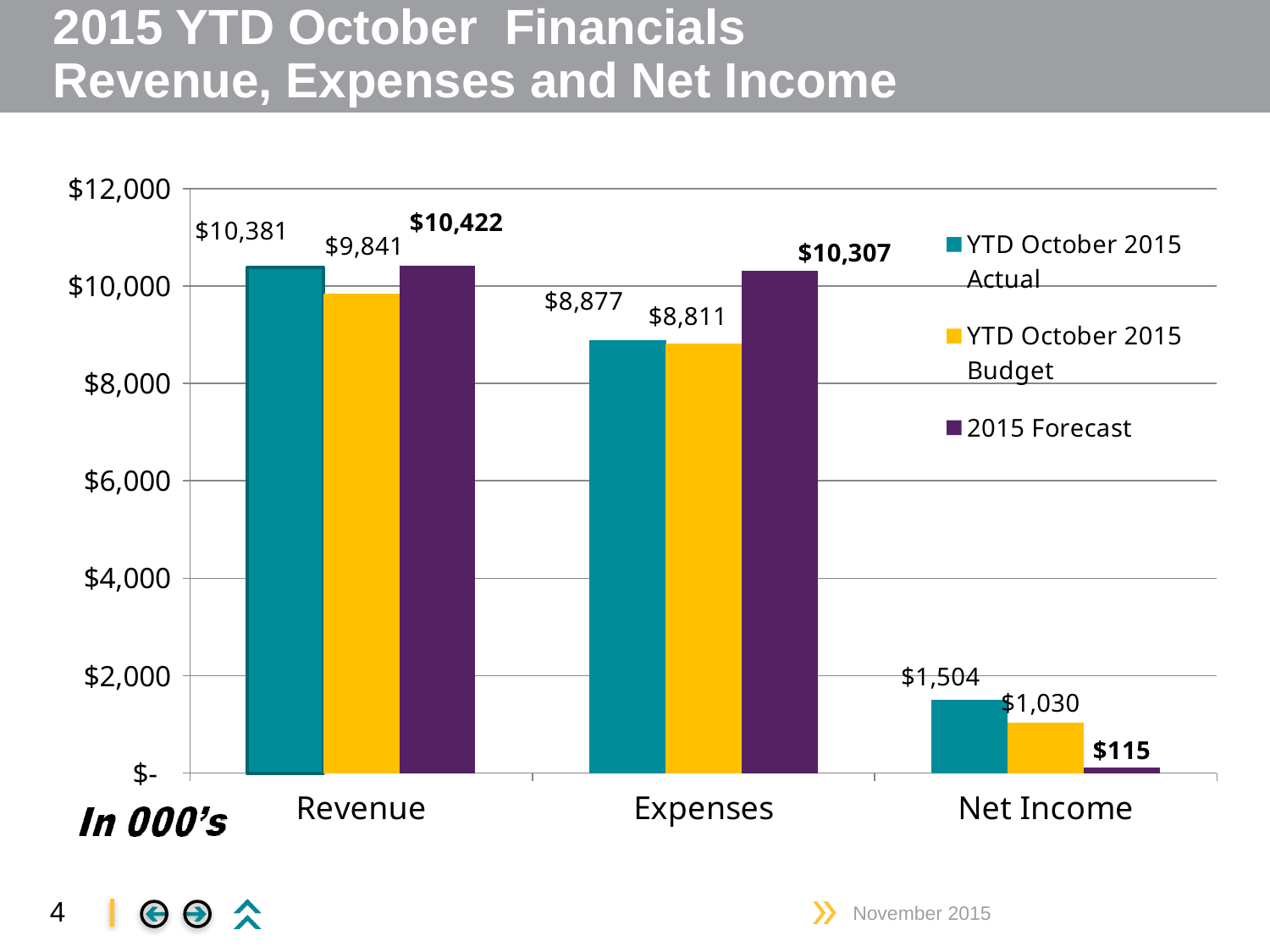
What is the 2015 Forecast value for Expenses? $10,307 What is the difference between the YTD October 2015 Actual and YTD October 2015 Budget values for Net Income? $474 How many categories are shown on the x axis? 3 Which category has the lowest 2015 Forecast value? Net Income What is the YTD October 2015 Budget value for Net Income? $1,030 Is the YTD October 2015 Budget value for Revenue greater or less than $10,000? less Which is larger for Expenses: the YTD October 2015 Actual value or the YTD October 2015 Budget value? YTD October 2015 Actual What unit note is shown below the y axis of the chart? In 000's How many series does the legend list? 3 Which series has the highest value for Revenue? 2015 Forecast What is the YTD October 2015 Actual value for Revenue? $10,381 What kind of chart is shown on the slide? bar chart